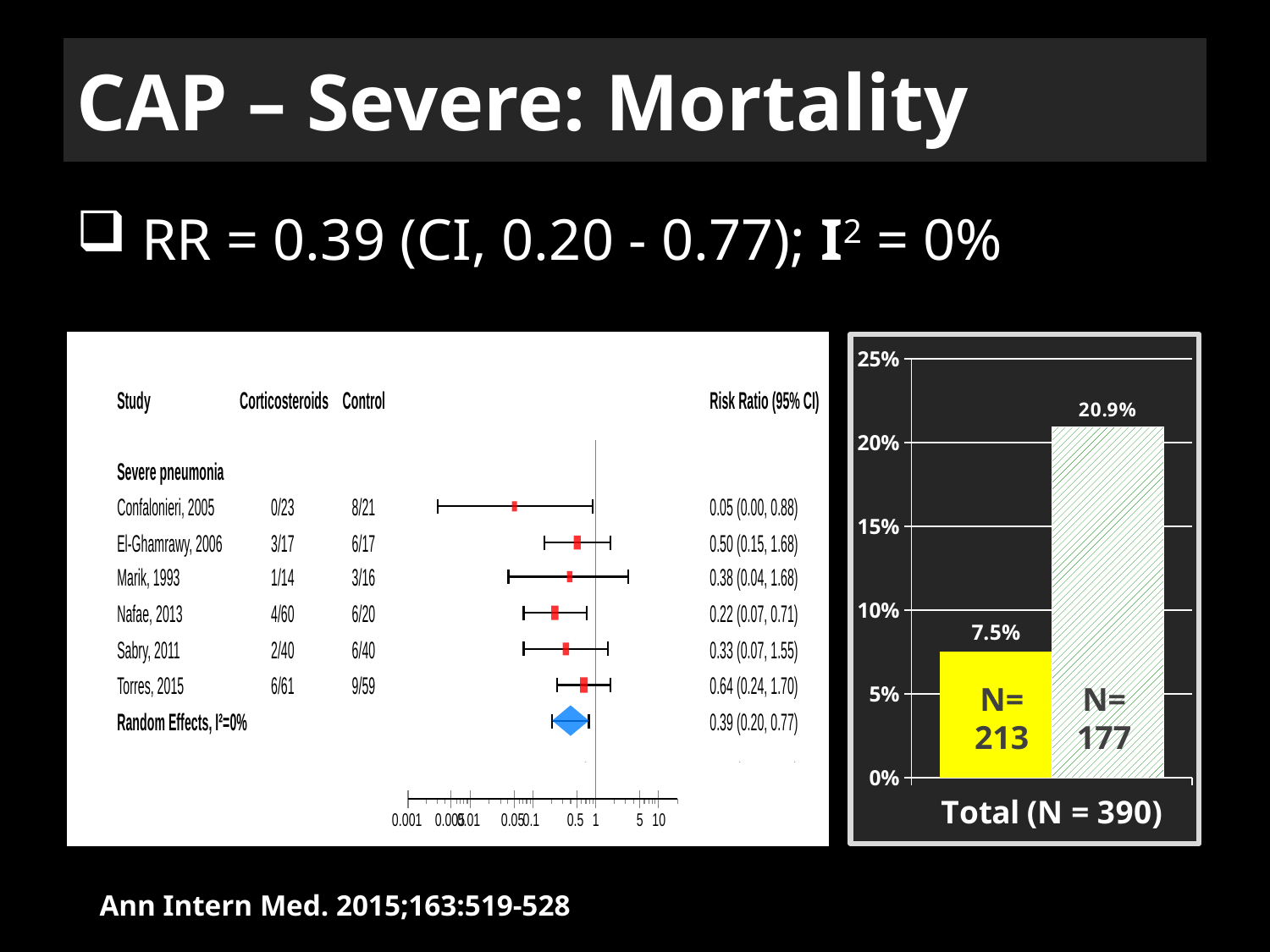
In the forest plot on the left, what is the pooled random effects risk ratio (95% CI)? 0.39 (0.20, 0.77) On the bar chart on the right, what is the value shown for the right (hatched) bar labelled N=177? 20.9% On the bar chart on the right, which bar is higher, the one labelled N=213 or the one labelled N=177? N=177 On the bar chart on the right, what is the difference between the two bar values? 13.4% In the forest plot on the left, how many individual studies are listed under Severe pneumonia? 6 On the bar chart on the right, what is the highest value shown on the vertical axis? 25% In the forest plot on the left, what is the risk ratio (95% CI) for Confalonieri, 2005? 0.05 (0.00, 0.88) In the forest plot on the left, what is the risk ratio (95% CI) for Torres, 2015? 0.64 (0.24, 1.70) On the bar chart on the right, what total N is given below the bars? Total (N = 390) On the bar chart on the right, what is the value shown for the left (yellow) bar labelled N=213? 7.5% On the bar chart on the right, how many bars are plotted? 2 What kind of chart is shown on the right side of the slide? Bar chart